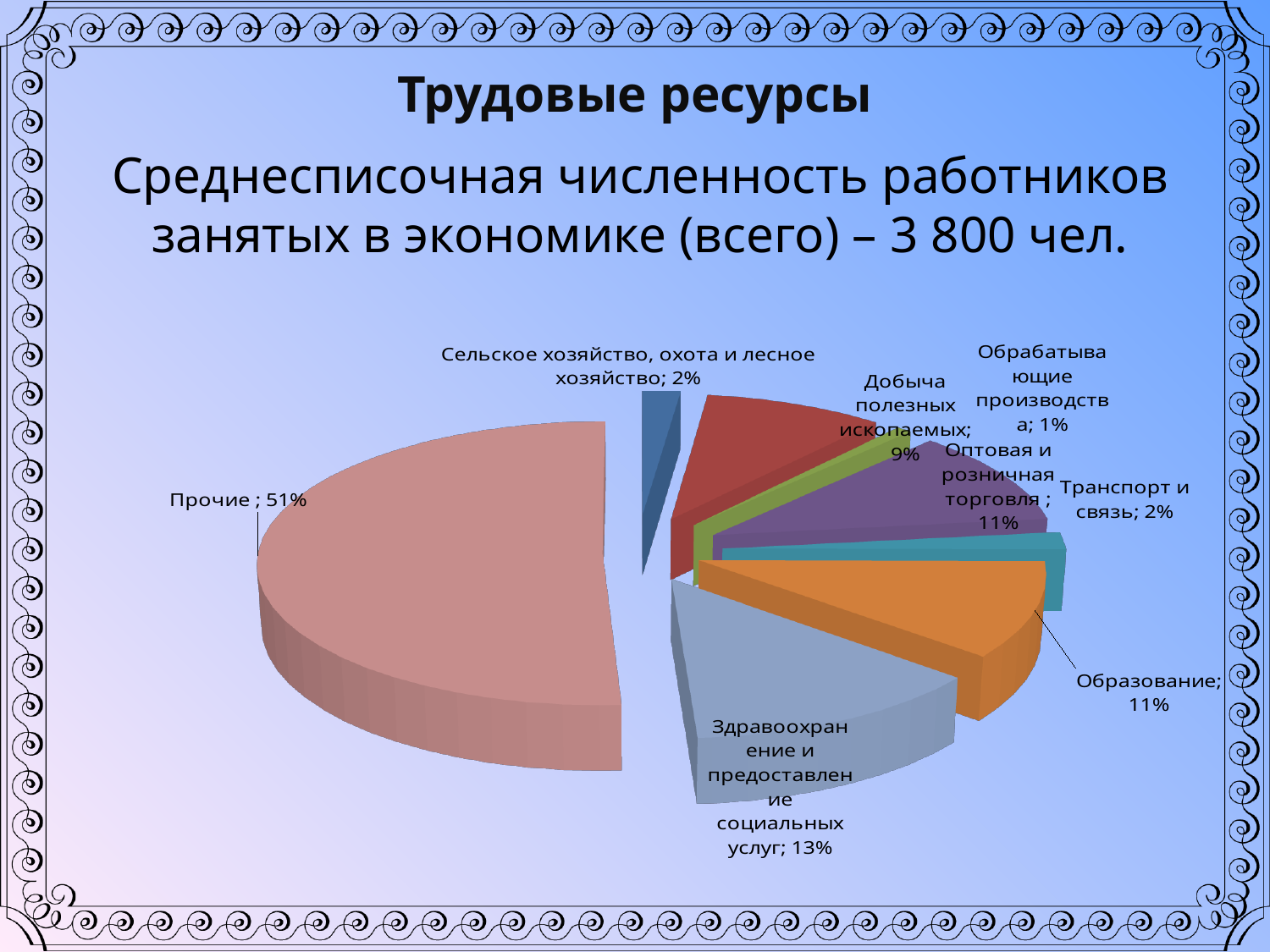
What total number of employees is stated in the slide heading? 3 800 чел. How many slices does the pie chart have? 8 What type of chart is shown on the slide? pie chart Which category has the largest slice of the pie? Прочие What share of the pie does "Прочие" account for? 51% What is the value for "Здравоохранение и предоставление социальных услуг"? 13% What is the difference between the shares of "Здравоохранение и предоставление социальных услуг" and "Добыча полезных ископаемых"? 4% What is the value for "Добыча полезных ископаемых"? 9% What is the value for "Образование"? 11% Which category has the smallest slice of the pie? Обрабатывающие производства What is the combined share of "Образование" and "Оптовая и розничная торговля"? 22% Which is larger: the share of "Оптовая и розничная торговля" or the share of "Транспорт и связь"? Оптовая и розничная торговля